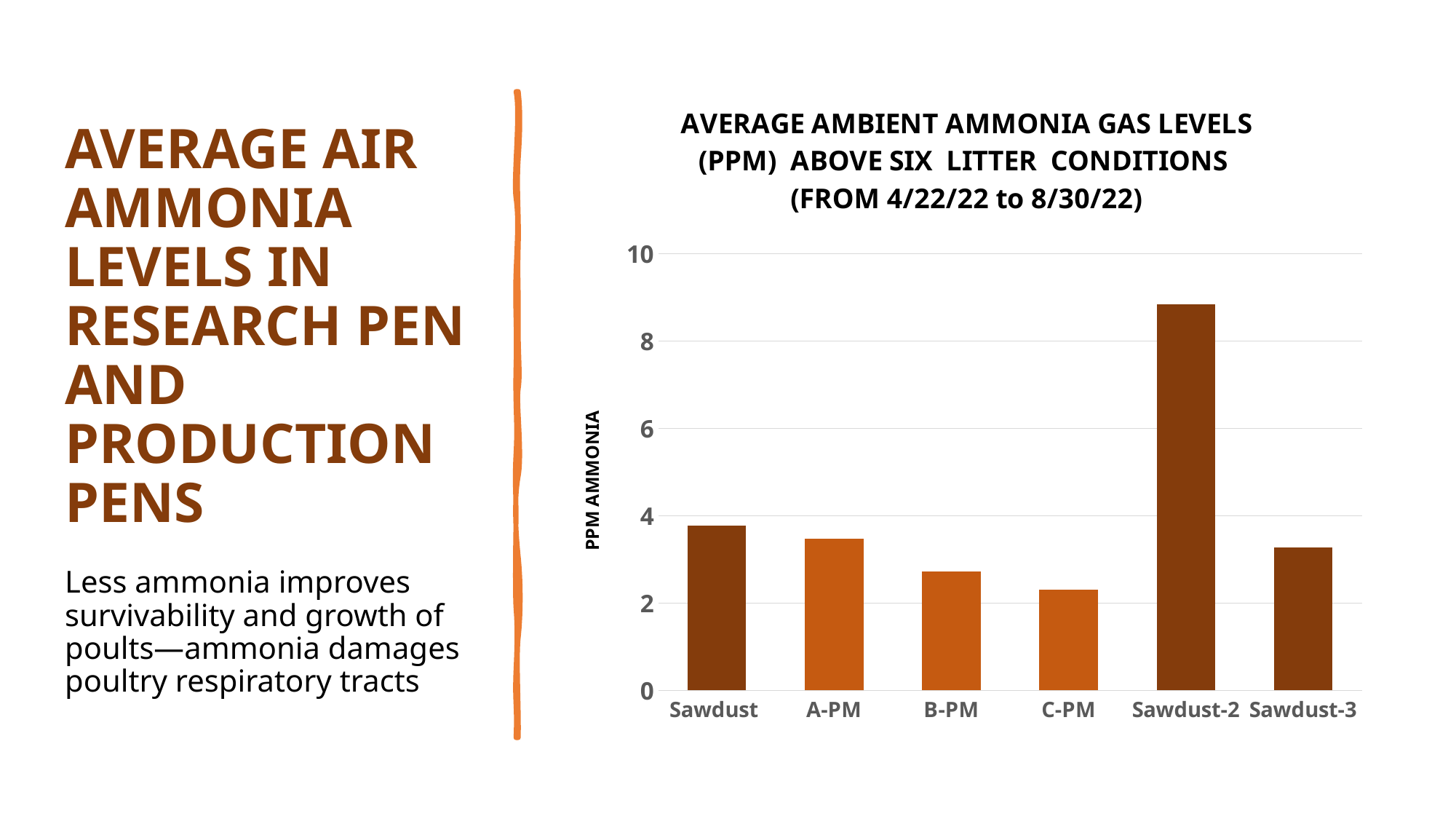
What kind of chart is shown on the slide? bar chart What is the label on the vertical axis of the chart? PPM AMMONIA How many litter conditions are plotted on the x axis? 6 Is the value for Sawdust-3 greater or less than 2? greater Is the value for Sawdust-2 greater or less than 8? greater Which litter condition has the lowest average ammonia level? C-PM Which has a higher average ammonia level, B-PM or C-PM? B-PM Is the value for B-PM greater or less than 4? less Which litter condition has the highest average ammonia level? Sawdust-2 Which has a higher average ammonia level, Sawdust or Sawdust-3? Sawdust